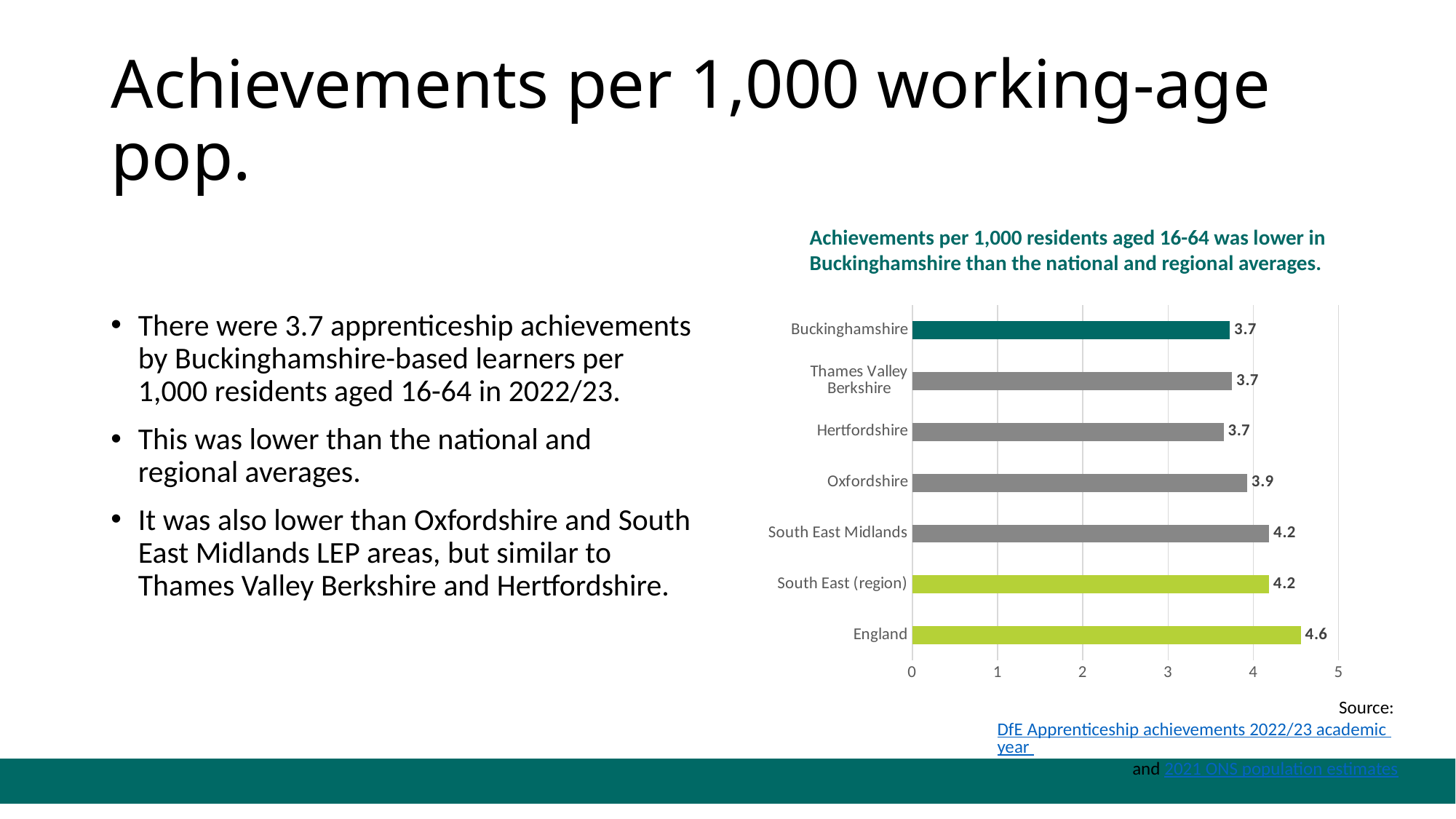
What is the value for Buckinghamshire? 3.7 What kind of chart is shown on the slide? Bar chart What is the difference between the values for England and Buckinghamshire? 0.9 How many categories are shown in the chart? 7 What is the value for South East Midlands? 4.2 What is the value for England? 4.6 Which is larger, the value for South East (region) or the value for Hertfordshire? South East (region) What is the difference between the values for Oxfordshire and Buckinghamshire? 0.2 Which category has the highest value? England What is the value for Oxfordshire? 3.9 What is the maximum value shown on the horizontal axis? 5 Is the value for England greater or less than 4? greater